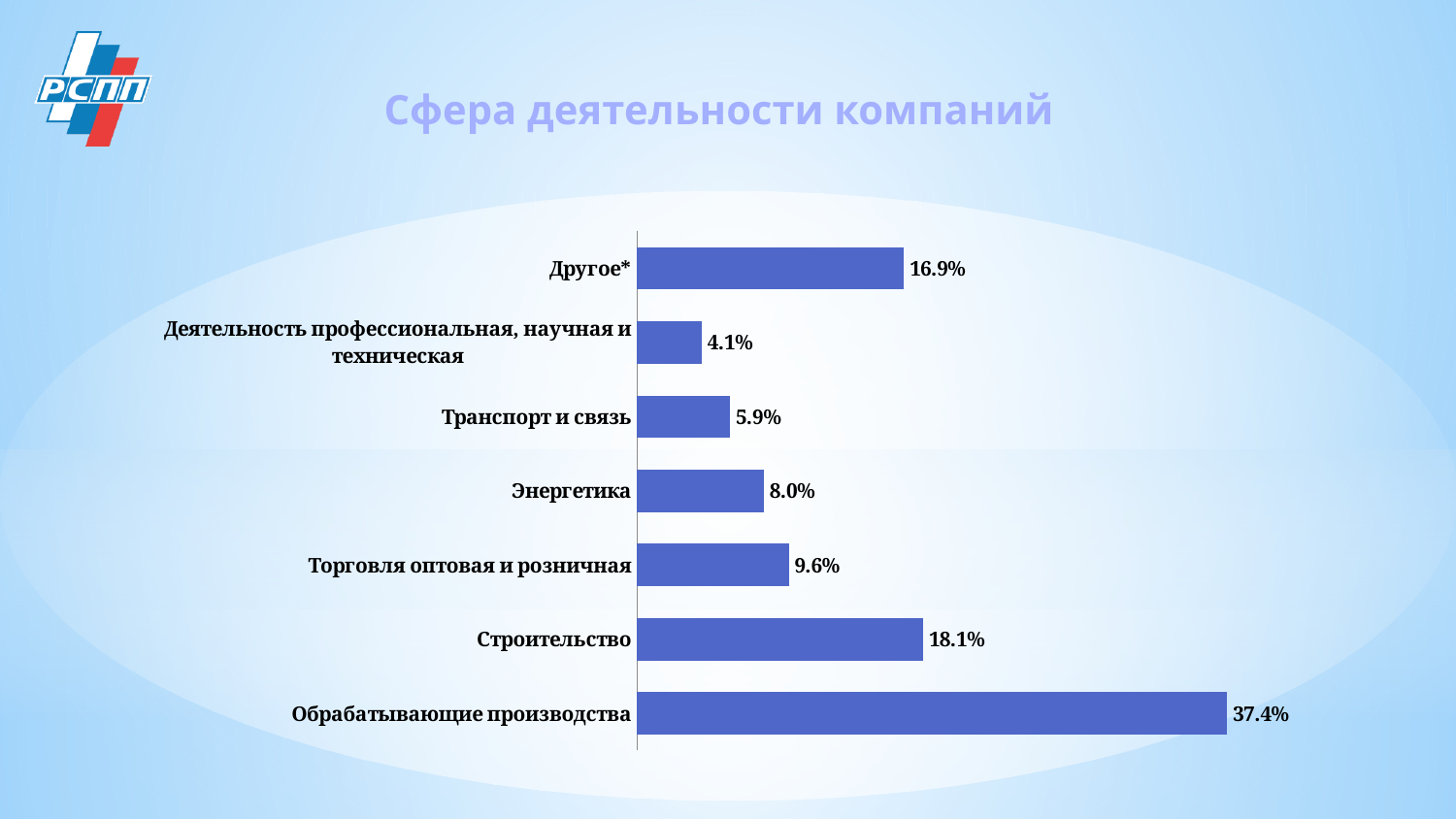
Which category has the highest value? Обрабатывающие производства What is the title of the slide? Сфера деятельности компаний What kind of chart is shown on the slide? Bar chart How many categories are shown in the chart? 7 Which is larger, the value for Другое* or the value for Строительство? Строительство What is the difference between the values for Обрабатывающие производства and Строительство? 19.3% What is the value for Обрабатывающие производства? 37.4% Which category has the lowest value? Деятельность профессиональная, научная и техническая What is the value for Деятельность профессиональная, научная и техническая? 4.1% What is the value for Энергетика? 8.0% What is the difference between the values for Торговля оптовая и розничная and Транспорт и связь? 3.7% What is the value for Строительство? 18.1%